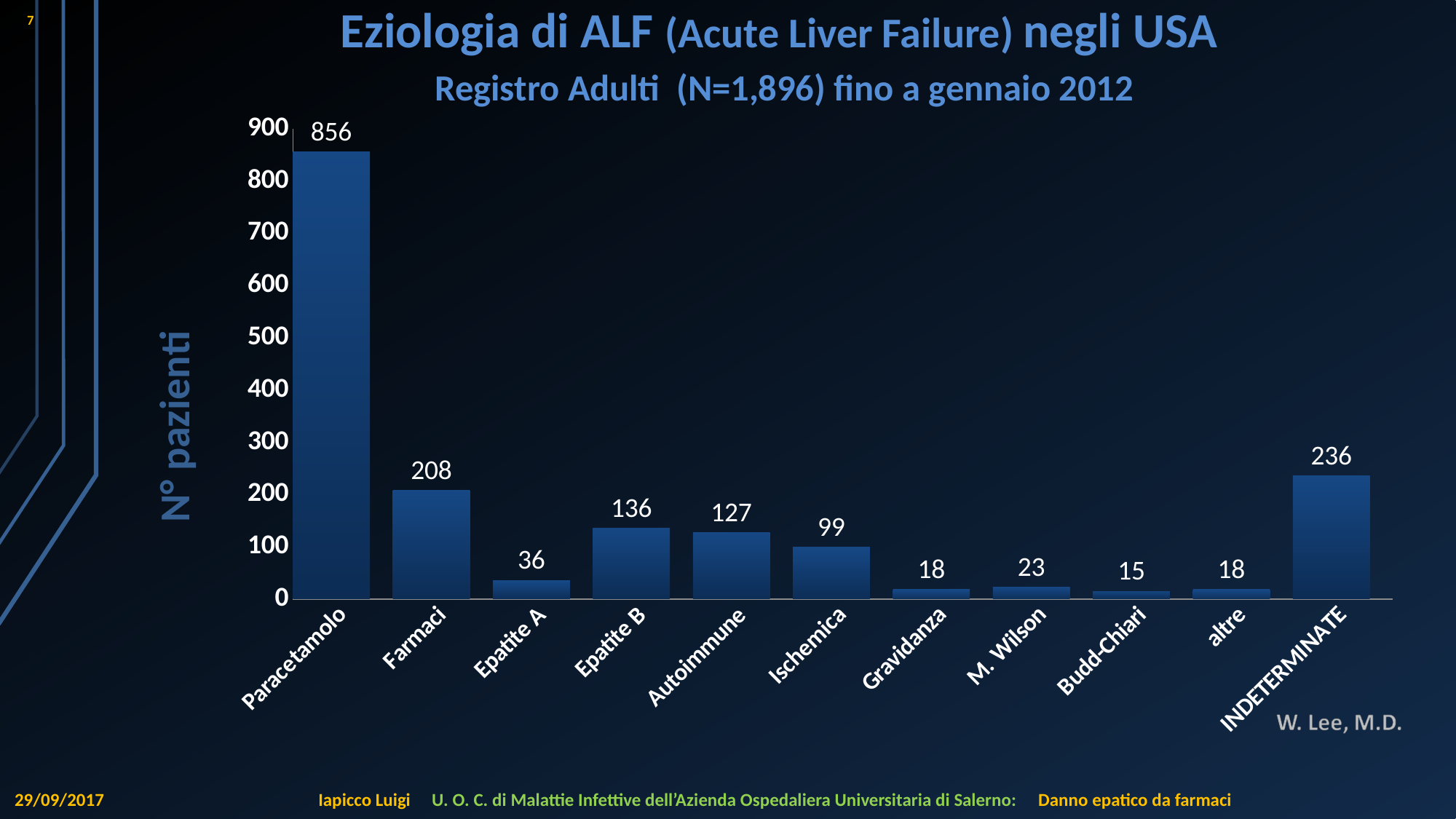
What kind of chart is shown on the slide? Bar chart What is the number of patients for INDETERMINATE? 236 Which has more patients, INDETERMINATE or Farmaci? INDETERMINATE What is the number of patients for Paracetamolo? 856 How many categories are shown on the x axis? 11 Which category has the lowest number of patients? Budd-Chiari What is the difference in number of patients between Paracetamolo and Farmaci? 648 Which has more patients, Epatite B or Autoimmune? Epatite B Which category has the highest number of patients? Paracetamolo What is the number of patients for Epatite B? 136 What is the label of the y axis? N° pazienti What is the number of patients for Farmaci? 208